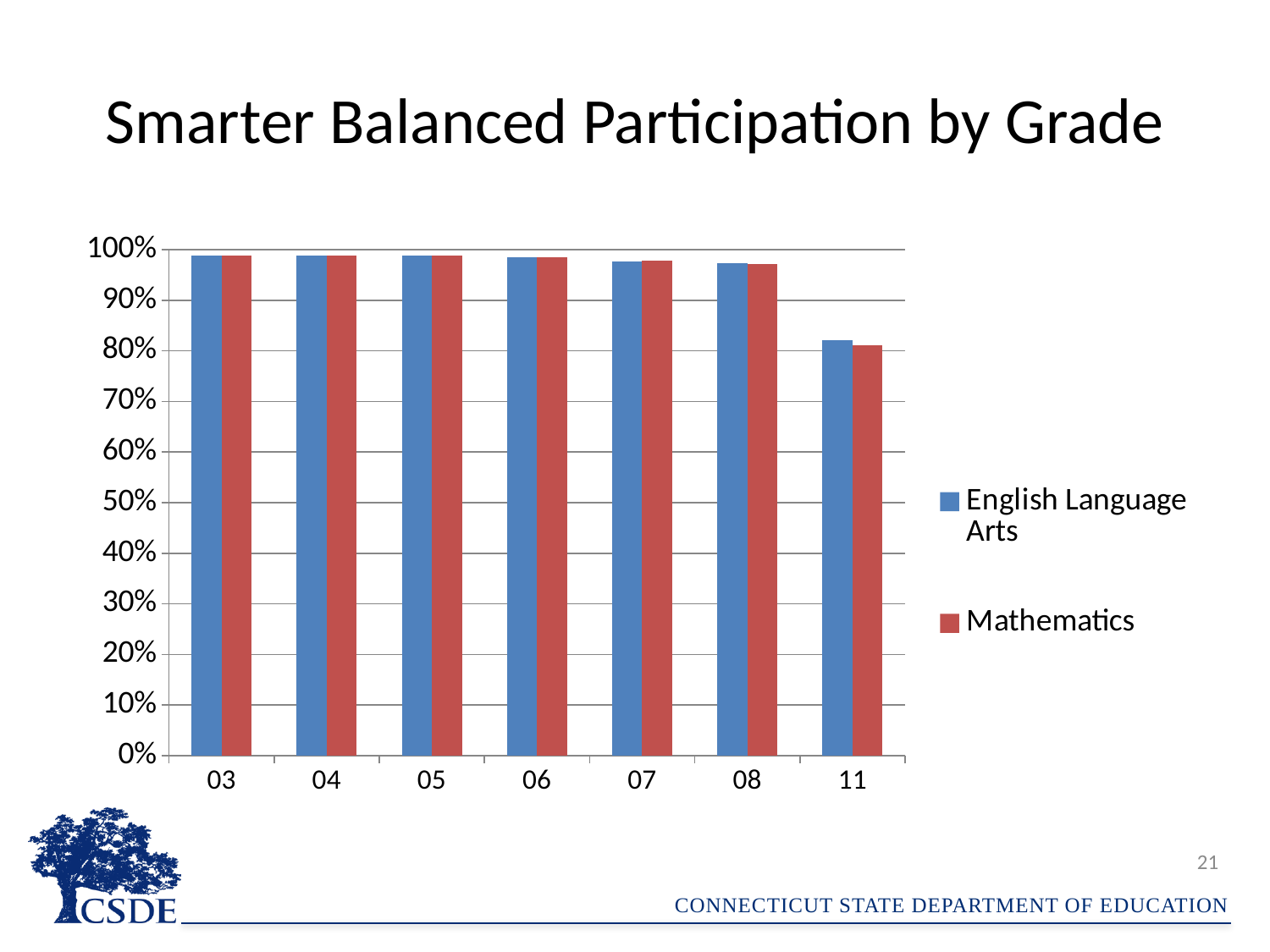
Do the participation values generally rise or fall as grade increases along the x axis? fall Is the Mathematics participation for grade 11 greater or less than 90%? less Which grade has the lowest Mathematics participation? 11 Is the Mathematics participation for grade 03 greater or less than 90%? greater Which is larger, the English Language Arts participation for grade 03 or for grade 11? grade 03 What kind of chart is shown on the slide? bar chart Is the English Language Arts participation for grade 11 greater or less than 90%? less How many grades are shown on the x axis of the chart? 7 Which grade has the lowest English Language Arts participation? 11 What is the title of the chart? Smarter Balanced Participation by Grade How many series does the chart's legend list? 2 Which series is shown in red in the chart? Mathematics